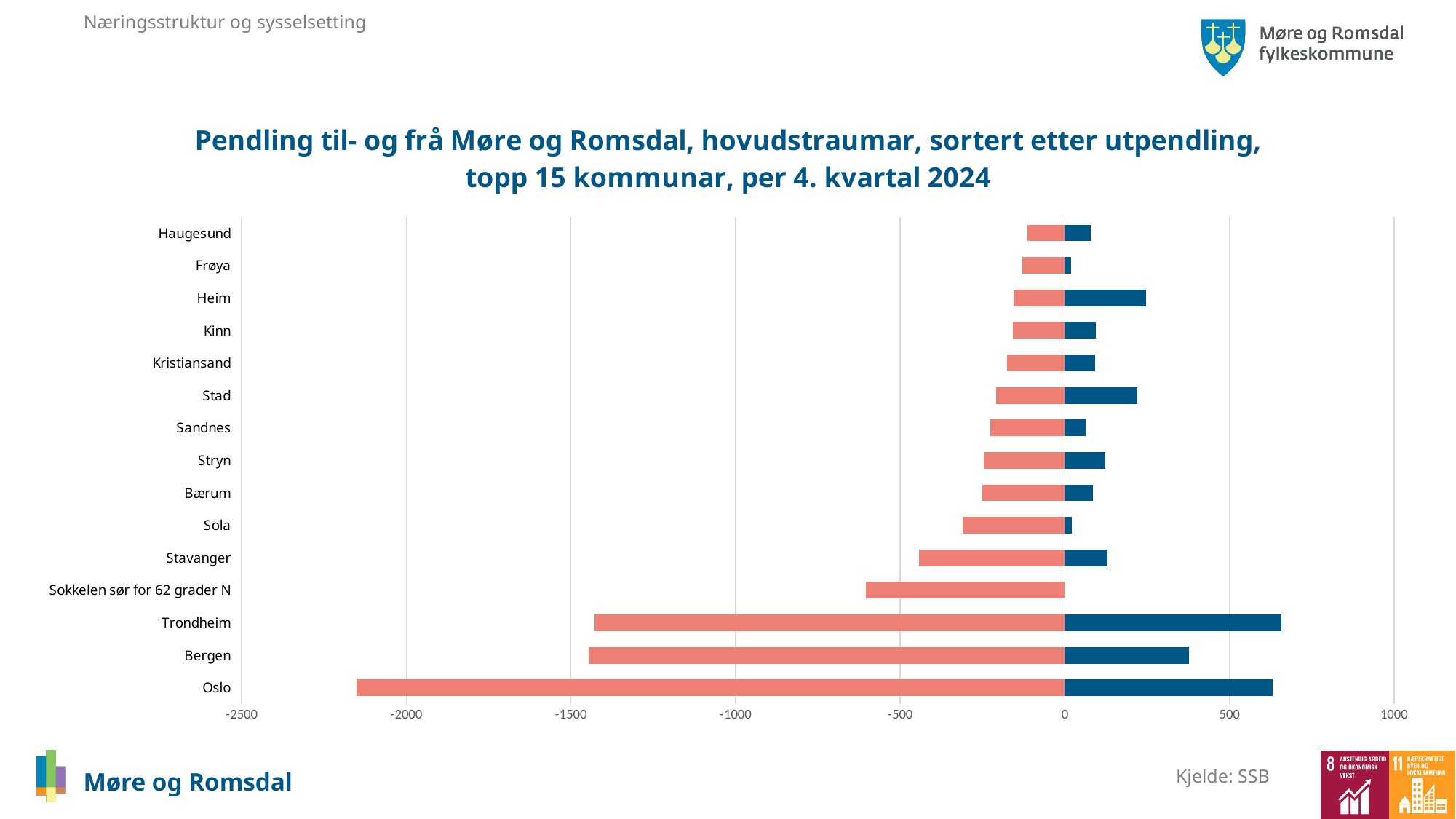
How many municipalities (categories) are listed on the vertical axis of the chart? 15 Is the blue bar for Bergen greater or less than 500? less What kind of chart is shown on the slide? bar chart Which category has no blue bar at all? Sokkelen sør for 62 grader N Is the blue bar for Trondheim greater or less than 500? greater Is the red bar for Stavanger greater or less than -500? greater What is the source cited for the chart data? SSB Which has the longer blue bar, Trondheim or Bergen? Trondheim Which has the longer blue bar, Heim or Frøya? Heim Which municipality has the longest red (utpendling) bar? Oslo